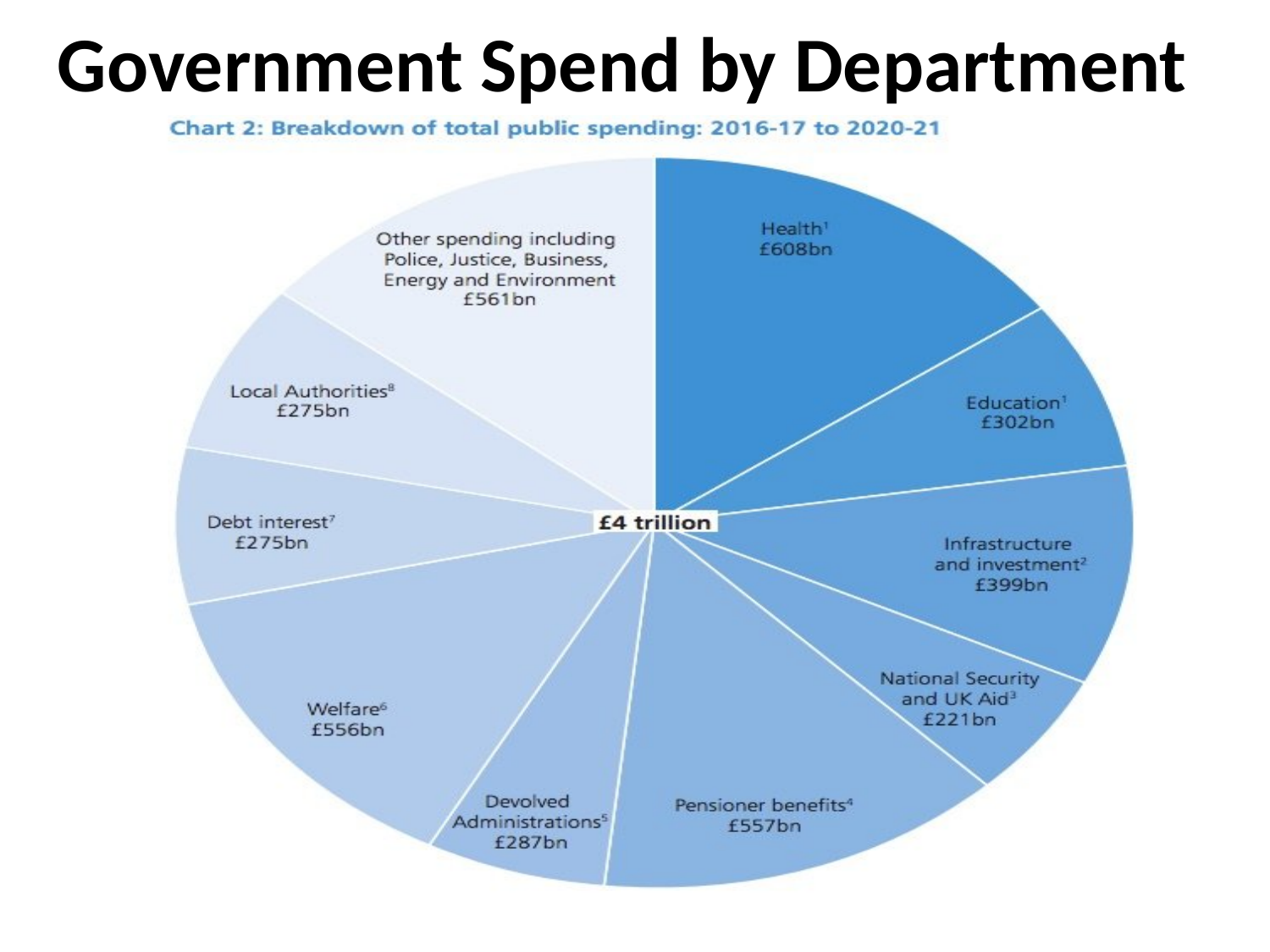
What is the value for Health in the pie chart? £608bn What is the difference between Infrastructure and investment and National Security and UK Aid? £178bn What is the value for Pensioner benefits? £557bn What kind of chart is shown on the slide? Pie chart What total is printed at the centre of the pie chart? £4 trillion Which is larger, Education or Infrastructure and investment? Infrastructure and investment How many slices does the pie chart have? 10 What is the value for Devolved Administrations? £287bn Which category has the largest slice of the pie? Health Which category has the smallest slice of the pie? National Security and UK Aid What is the difference between the Health and Education values? £306bn What is the value for Infrastructure and investment? £399bn